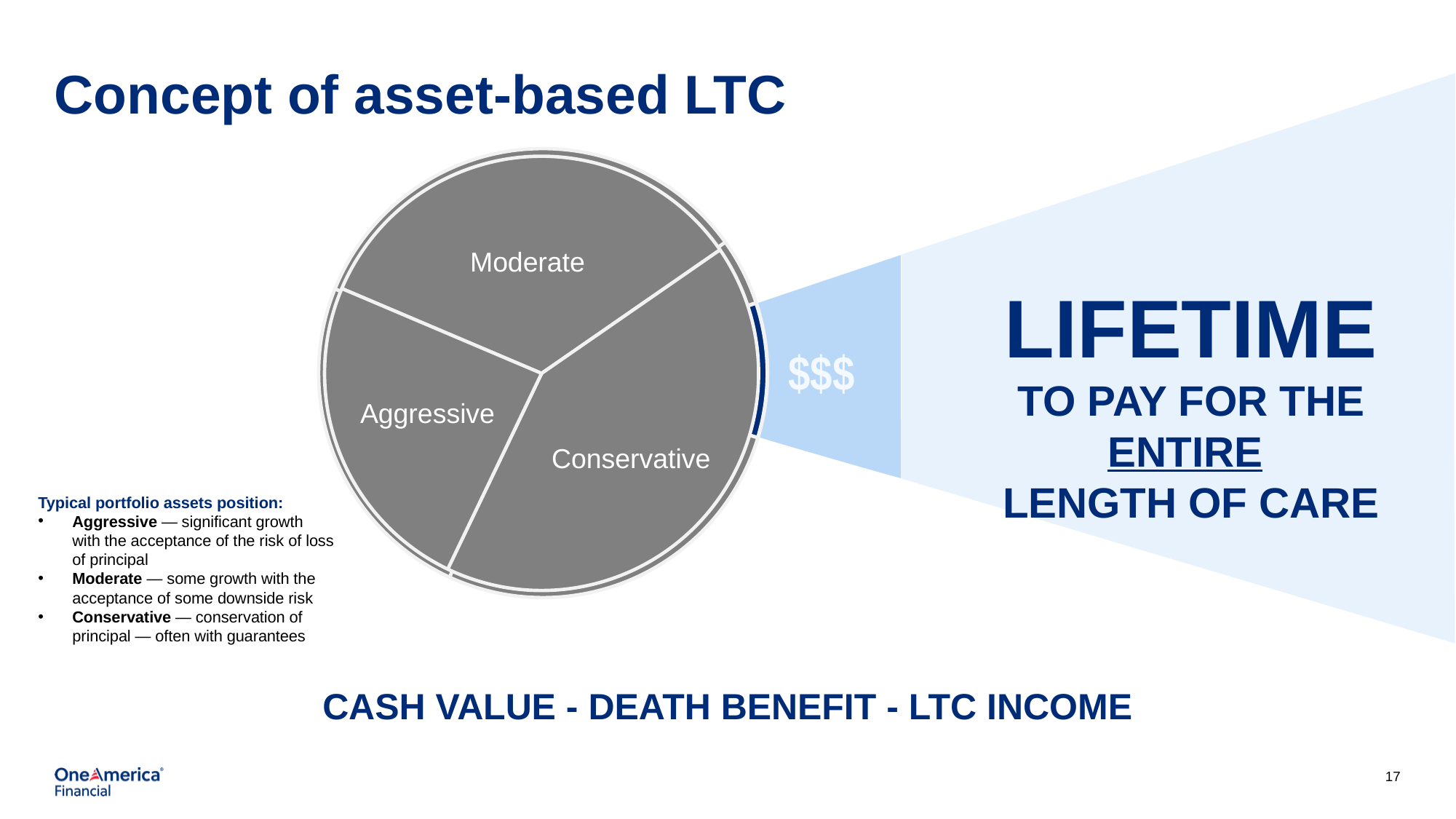
What are the names of the three labeled slices in the pie chart? Moderate, Aggressive, Conservative What text appears immediately to the right of the small dark blue sliver of the pie chart? $$$ What kind of chart is shown on the slide? pie chart Which slice is larger, Moderate or Aggressive? Moderate Which slice is larger, Moderate or Conservative? Conservative Which labeled slice of the pie chart is the largest? Conservative How many labeled slices does the pie chart have? 3